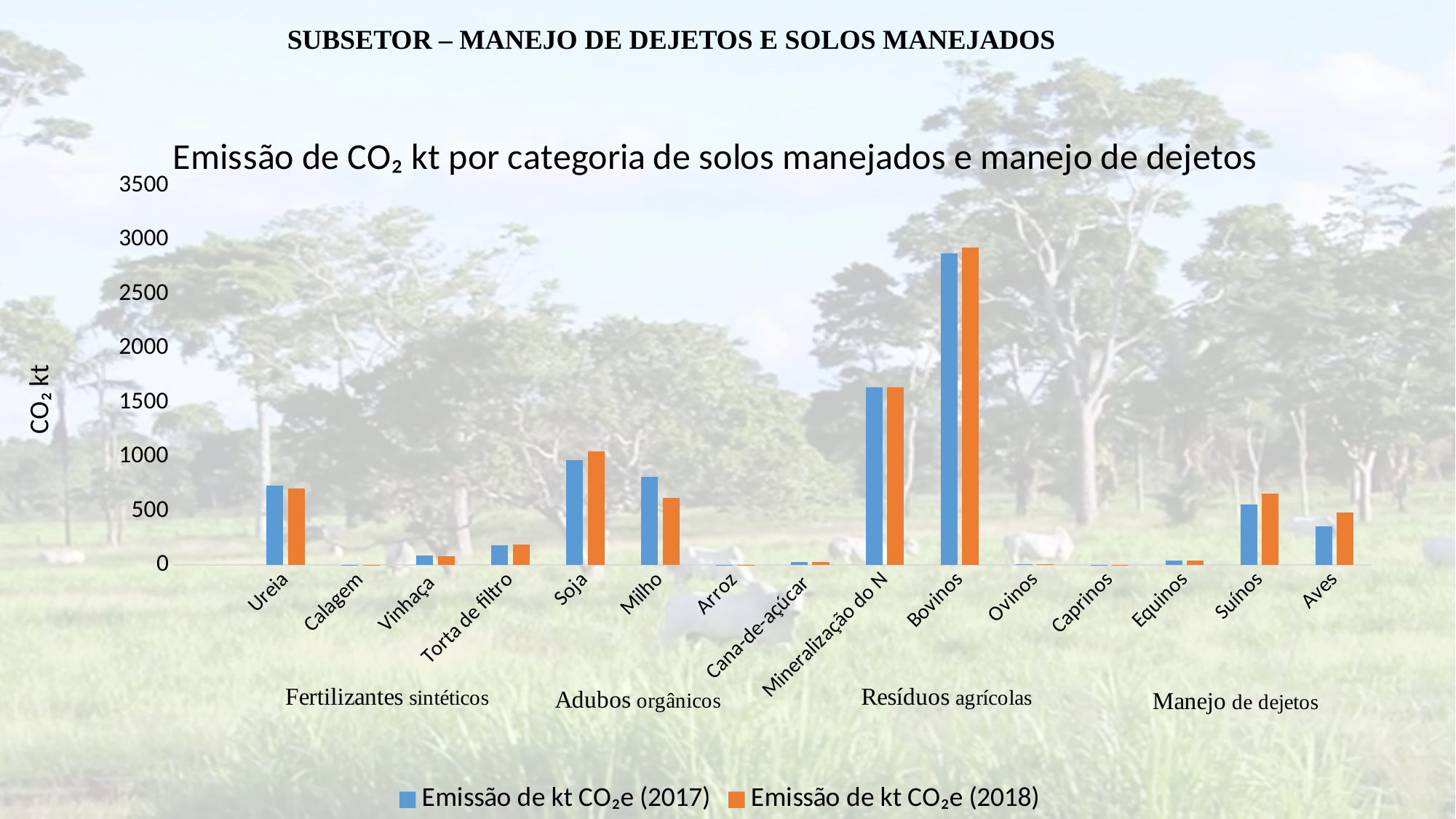
For Suínos, which series is larger: Emissão de kt CO₂e (2017) or Emissão de kt CO₂e (2018)? Emissão de kt CO₂e (2018) Is the value for Mineralização do N in Emissão de kt CO₂e (2018) greater or less than 1500? greater Is the value for Torta de filtro in Emissão de kt CO₂e (2018) greater or less than 500? less Is the value for Bovinos in Emissão de kt CO₂e (2017) greater or less than 2500? greater How many categories are shown on the x axis? 15 What is the title of the chart? Emissão de CO₂ kt por categoria de solos manejados e manejo de dejetos Which category has the highest emission for Emissão de kt CO₂e (2017)? Bovinos For Milho, which series is larger: Emissão de kt CO₂e (2017) or Emissão de kt CO₂e (2018)? Emissão de kt CO₂e (2017) What kind of chart is shown on the slide? bar chart How many series does the legend list? 2 Which category has the highest emission for Emissão de kt CO₂e (2018)? Bovinos